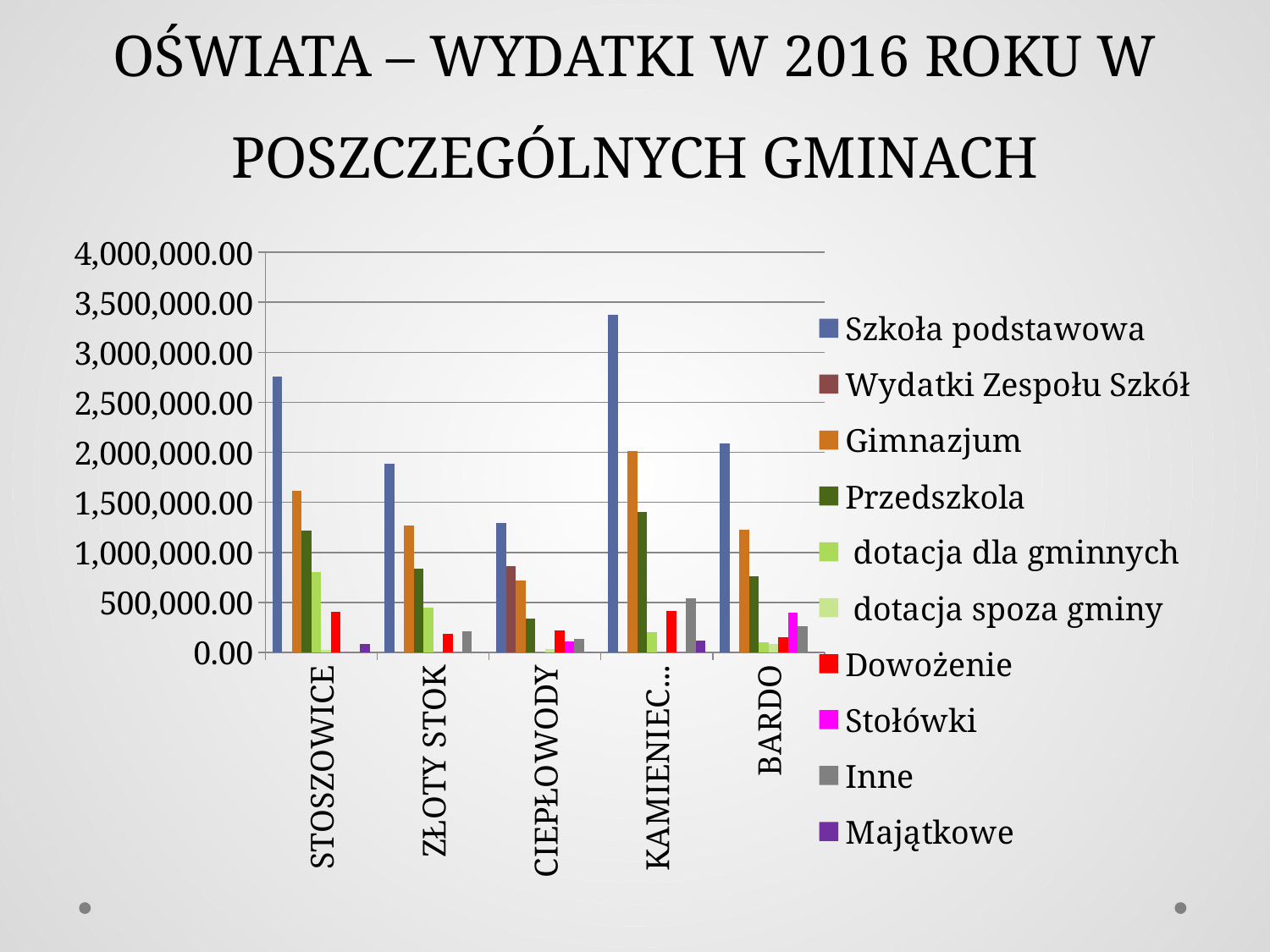
In BARDO, which is larger: Stołówki or Dowożenie? Stołówki Is the value for Gimnazjum in STOSZOWICE greater or less than 1,000,000.00? greater In STOSZOWICE, which is larger: Szkoła podstawowa or Gimnazjum? Szkoła podstawowa Is the value for Szkoła podstawowa in CIEPŁOWODY greater or less than 1,000,000.00? greater What kind of chart is shown on the slide? bar chart Is the value for Przedszkola in CIEPŁOWODY greater or less than 500,000.00? less Which gmina has the lowest value for Gimnazjum? CIEPŁOWODY What colour are the bars for the Dowożenie series? red How many gminas (categories) are shown on the x axis? 5 Which gmina has the lowest value for Szkoła podstawowa? CIEPŁOWODY How many series does the legend list? 10